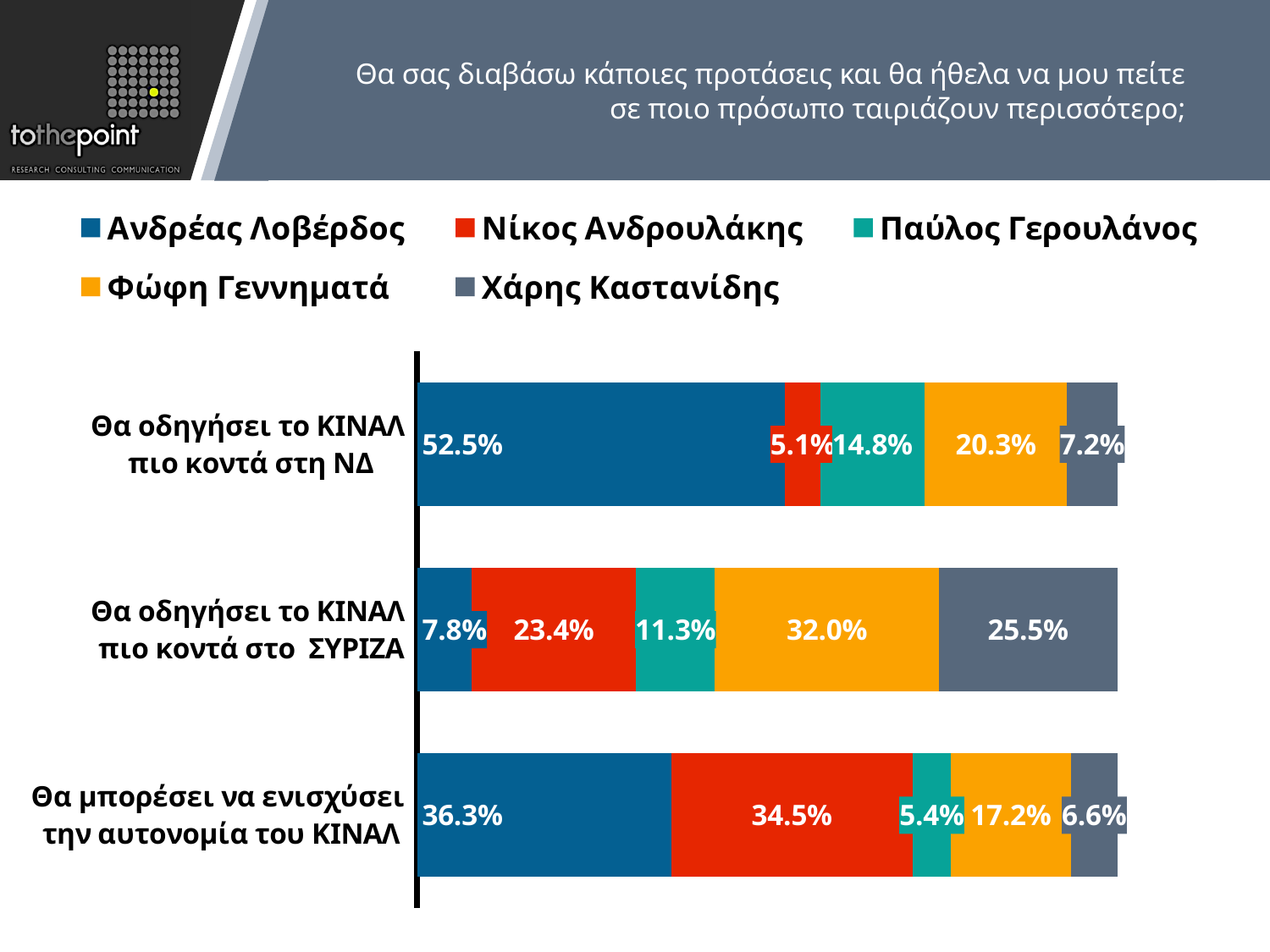
Which colour represents Χάρης Καστανίδης in the legend? Grey What is the value for Φώφη Γεννηματά in the statement 'Θα οδηγήσει το ΚΙΝΑΛ πιο κοντά στο ΣΥΡΙΖΑ'? 32.0% How many series does the legend list? 5 Which person has the lowest value for the statement 'Θα οδηγήσει το ΚΙΝΑΛ πιο κοντά στη ΝΔ'? Νίκος Ανδρουλάκης What is the value for Ανδρέας Λοβέρδος in the statement 'Θα οδηγήσει το ΚΙΝΑΛ πιο κοντά στη ΝΔ'? 52.5% Which person has the highest value for the statement 'Θα οδηγήσει το ΚΙΝΑΛ πιο κοντά στο ΣΥΡΙΖΑ'? Φώφη Γεννηματά What kind of chart is shown on the slide? Stacked bar chart How many statements (categories) are plotted on the chart? 3 What is the total of the stacked bar for 'Θα οδηγήσει το ΚΙΝΑΛ πιο κοντά στο ΣΥΡΙΖΑ'? 100.0% What is the difference between the values for Ανδρέας Λοβέρδος and Φώφη Γεννηματά in the statement 'Θα οδηγήσει το ΚΙΝΑΛ πιο κοντά στη ΝΔ'? 32.2% What is the value for Νίκος Ανδρουλάκης in the statement 'Θα μπορέσει να ενισχύσει την αυτονομία του ΚΙΝΑΛ'? 34.5% In the statement 'Θα μπορέσει να ενισχύσει την αυτονομία του ΚΙΝΑΛ', which is larger: the value for Παύλος Γερουλάνος or for Χάρης Καστανίδης? Χάρης Καστανίδης